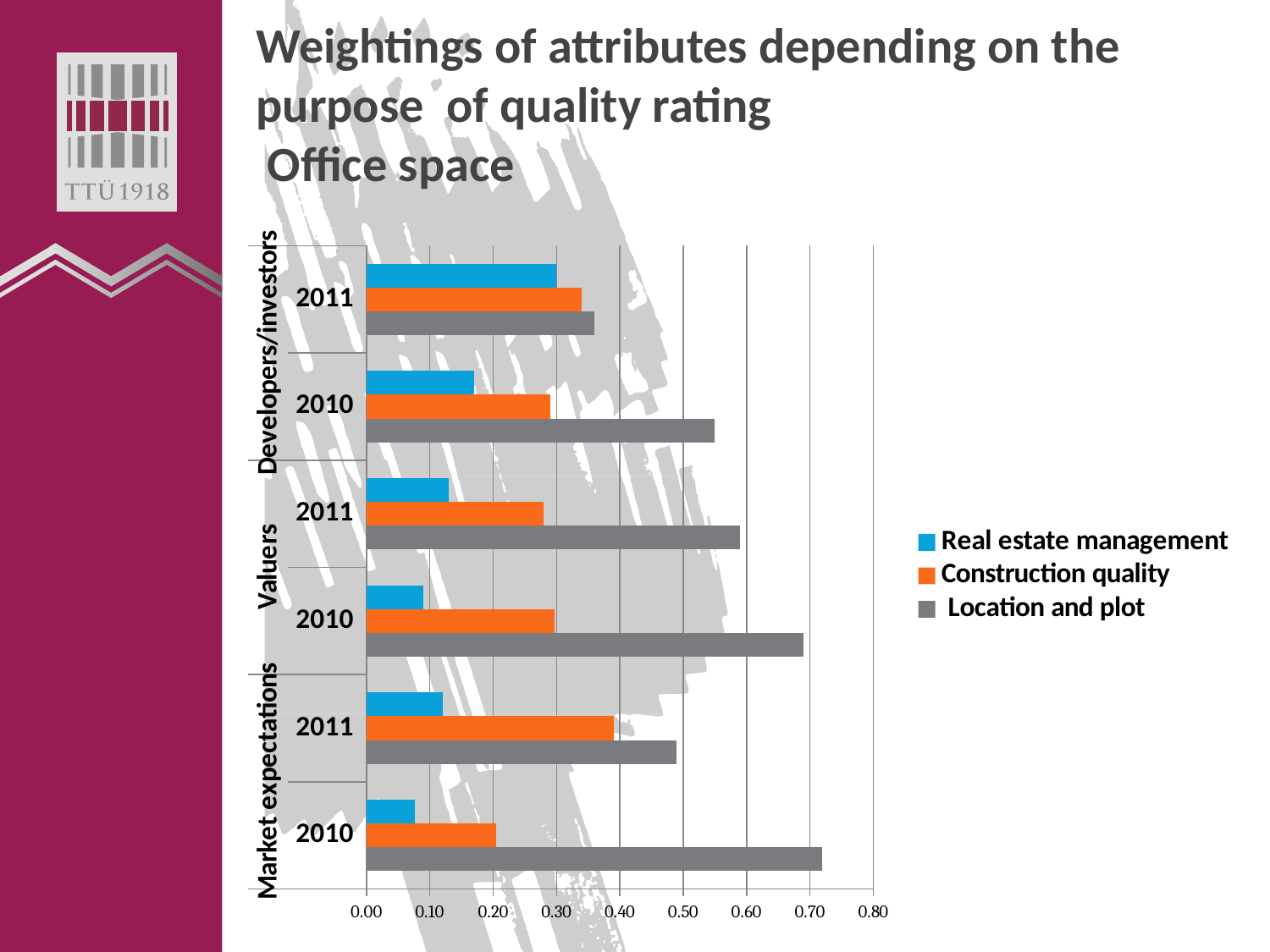
Which category has the lowest Location and plot value? Developers/investors 2011 Which is larger: the Location and plot value for Valuers 2010 or for Developers/investors 2010? Valuers 2010 What kind of chart is shown on the slide? Bar chart Which category has the highest Real estate management value? Developers/investors 2011 Which category has the lowest Construction quality value? Market expectations 2010 Is the Real estate management value for Developers/investors 2010 greater or less than 0.20? less Which series is shown in orange in the legend? Construction quality How many year categories are plotted on the chart? 6 Is the Location and plot value for Developers/investors 2011 greater or less than 0.40? less Is the Construction quality value for Market expectations 2011 greater or less than 0.30? greater How many series does the legend list? 3